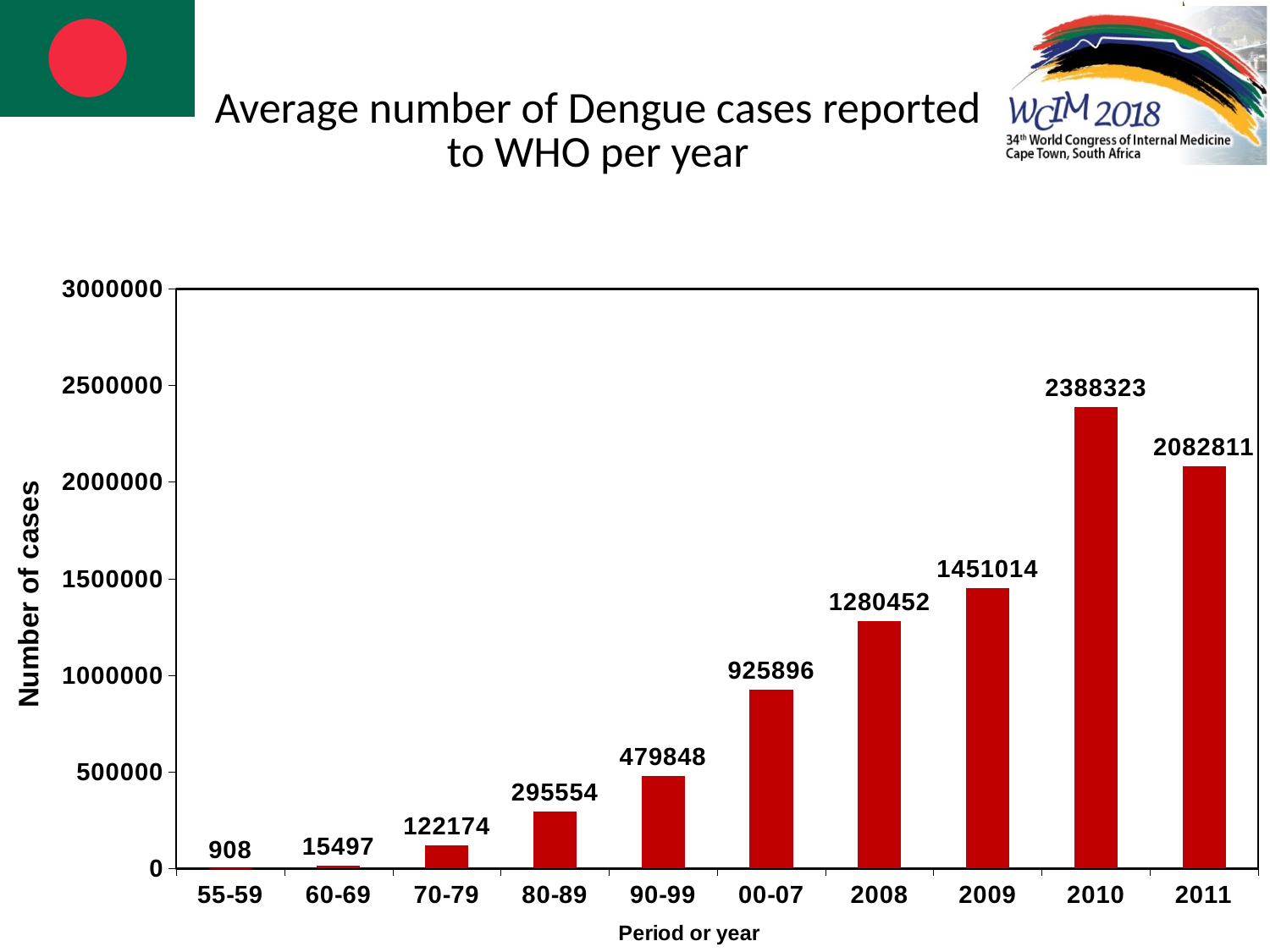
Which period or year has the highest number of cases? 2010 Which period or year has the lowest number of cases? 55-59 What is the label of the y axis? Number of cases What kind of chart is shown on the slide? bar chart How many periods or years are shown on the x axis? 10 What is the value shown for the period 55-59? 908 What is the average number of Dengue cases reported to WHO per year for 2010? 2388323 What is the value shown for the period 90-99? 479848 What is the difference between the values for 2010 and 2011? 305512 Is the value for 2009 greater or less than 1500000? less Do the values generally rise or fall from 55-59 to 2010? rise Which is larger, the value for 2008 or the value for 00-07? 2008